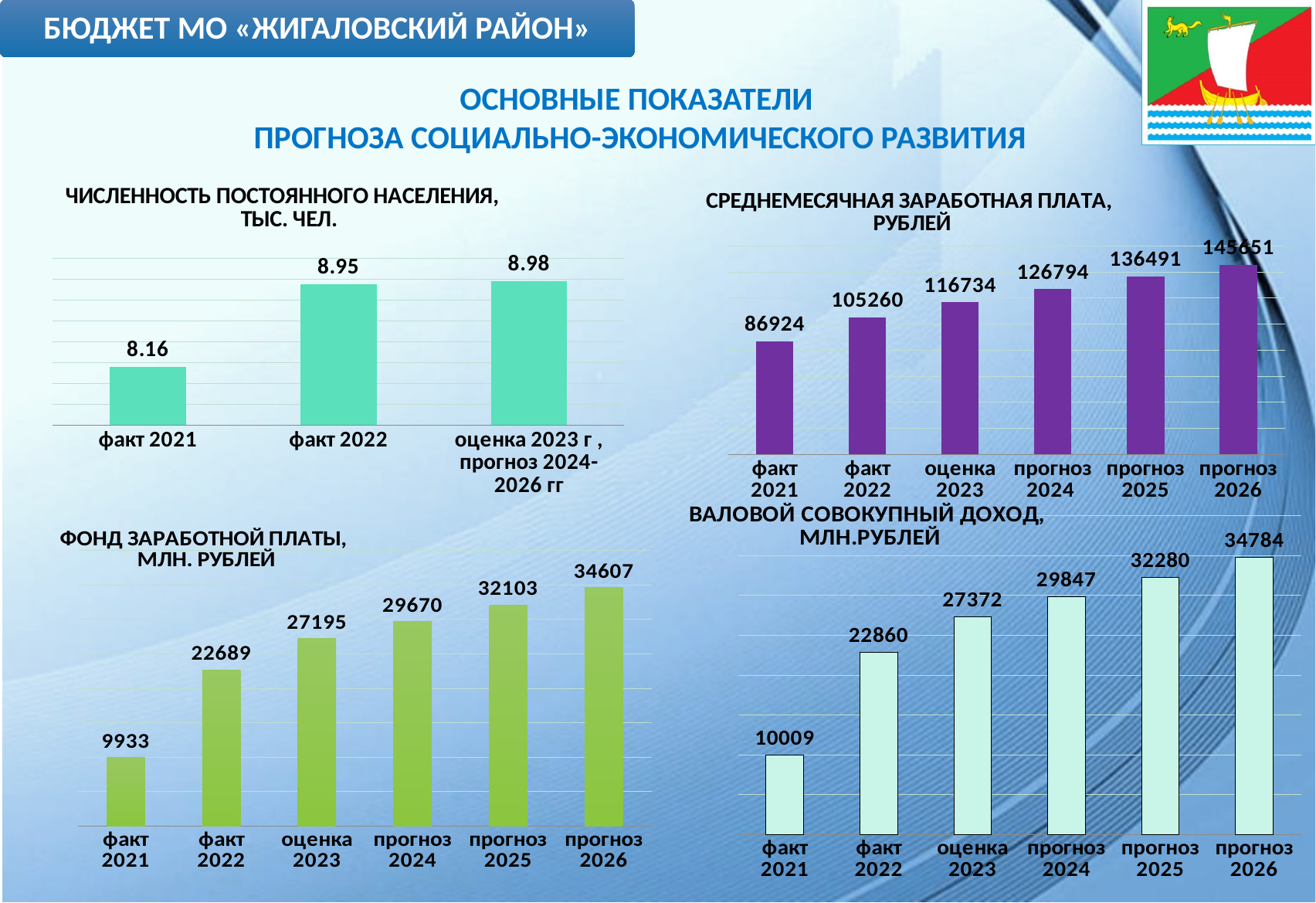
In the chart titled «ЧИСЛЕННОСТЬ ПОСТОЯННОГО НАСЕЛЕНИЯ, ТЫС. ЧЕЛ.», how many bars are plotted? 3 In the chart titled «ВАЛОВОЙ СОВОКУПНЫЙ ДОХОД, МЛН.РУБЛЕЙ», what is the value for факт 2021? 10009 In the chart titled «СРЕДНЕМЕСЯЧНАЯ ЗАРАБОТНАЯ ПЛАТА, РУБЛЕЙ», do the values rise or fall from факт 2021 to прогноз 2026? rise What kind of chart is the one titled «ФОНД ЗАРАБОТНОЙ ПЛАТЫ, МЛН. РУБЛЕЙ»? bar chart In the chart titled «ЧИСЛЕННОСТЬ ПОСТОЯННОГО НАСЕЛЕНИЯ, ТЫС. ЧЕЛ.», what is the value for факт 2022? 8.95 In the chart titled «СРЕДНЕМЕСЯЧНАЯ ЗАРАБОТНАЯ ПЛАТА, РУБЛЕЙ», what is the difference between факт 2022 and факт 2021? 18336 In the chart titled «ФОНД ЗАРАБОТНОЙ ПЛАТЫ, МЛН. РУБЛЕЙ», what is the difference between прогноз 2026 and прогноз 2025? 2504 In the chart titled «СРЕДНЕМЕСЯЧНАЯ ЗАРАБОТНАЯ ПЛАТА, РУБЛЕЙ», which category has the highest value? прогноз 2026 In the chart titled «ФОНД ЗАРАБОТНОЙ ПЛАТЫ, МЛН. РУБЛЕЙ», what is the value for оценка 2023? 27195 In the chart titled «ЧИСЛЕННОСТЬ ПОСТОЯННОГО НАСЕЛЕНИЯ, ТЫС. ЧЕЛ.», which category has the lowest value? факт 2021 In the chart titled «ВАЛОВОЙ СОВОКУПНЫЙ ДОХОД, МЛН.РУБЛЕЙ», which is larger, прогноз 2024 or оценка 2023? прогноз 2024 In the chart titled «СРЕДНЕМЕСЯЧНАЯ ЗАРАБОТНАЯ ПЛАТА, РУБЛЕЙ», what is the value for прогноз 2025? 136491